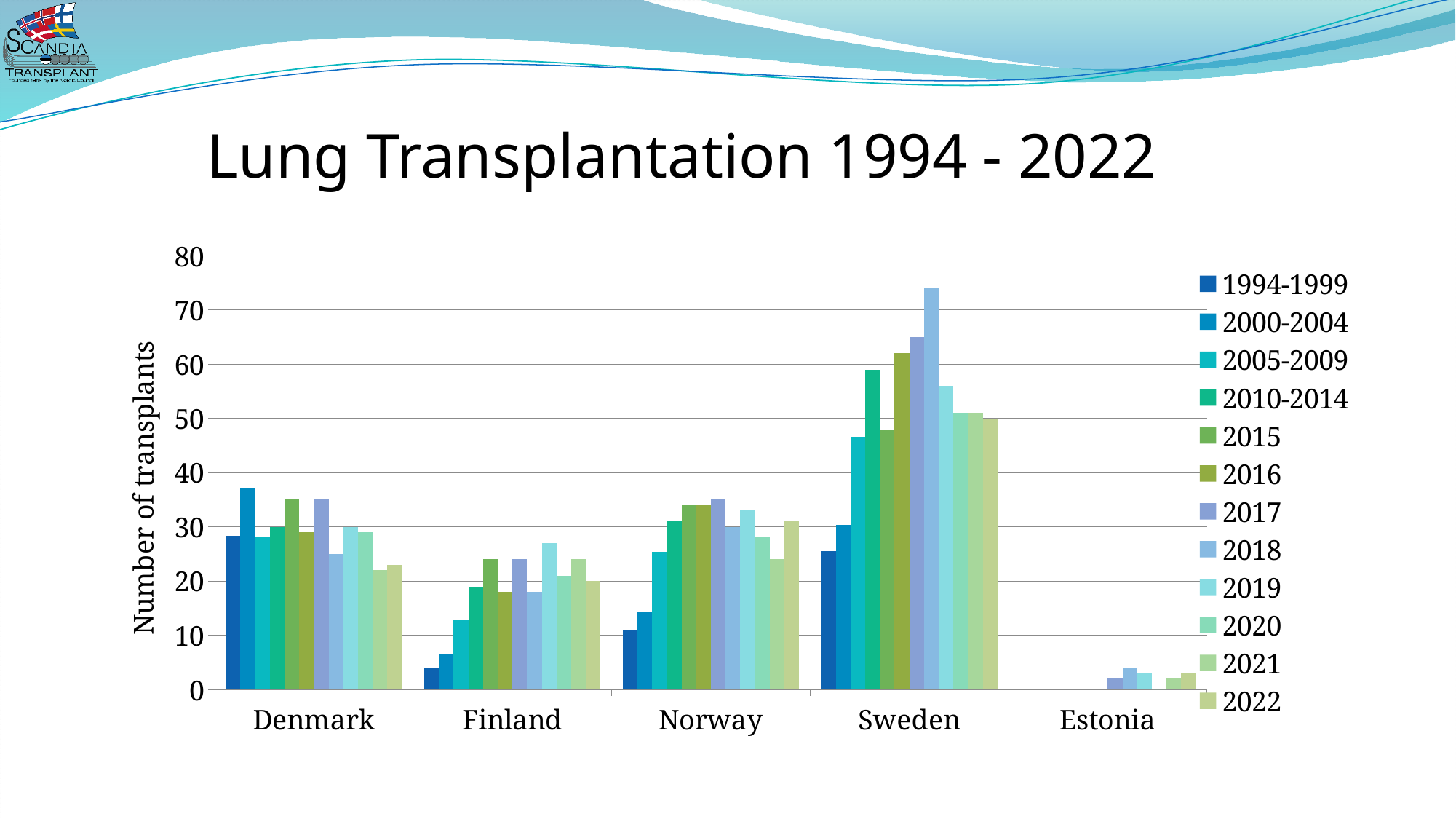
Which is larger, the 2018 value for Sweden or the 2018 value for Denmark? Sweden Which country has the lowest bars overall in the chart? Estonia How many series does the legend list? 12 Is the value for Finland in 1994-1999 greater or less than 10? less What kind of chart is shown on the slide? bar chart For Finland, which period has the lowest number of transplants? 1994-1999 For Sweden, which period has the highest number of transplants? 2018 What is the title of the y axis? Number of transplants Is the value for Sweden in 2018 greater or less than 70? greater Which country has the tallest bar in the chart? Sweden How many countries are shown on the x axis of the chart? 5 Is the value for Denmark in 2000-2004 greater or less than 30? greater